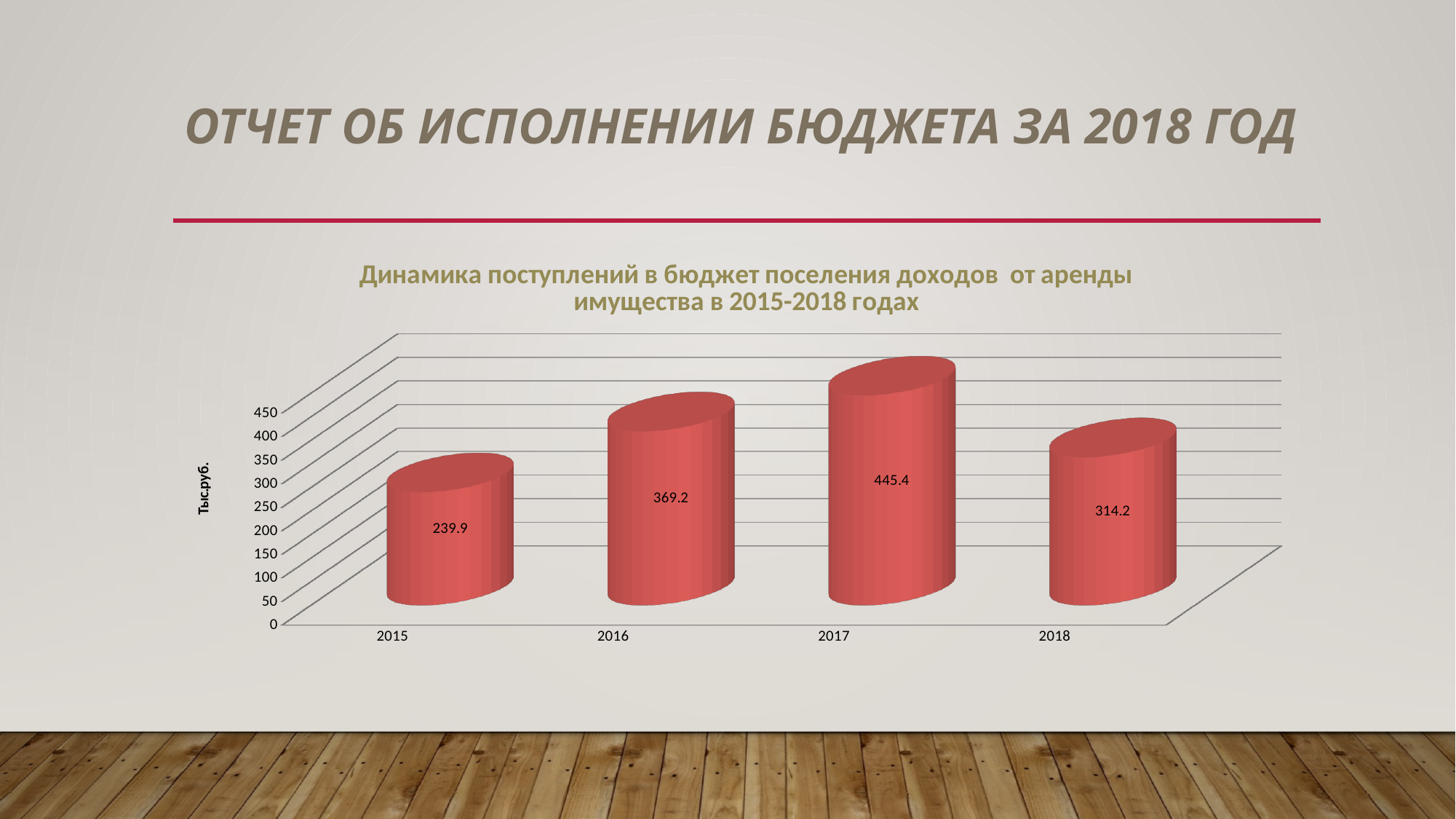
What is the difference between the values for 2017 and 2016? 76.2 Which is larger, the value for 2016 or the value for 2018? 2016 Which year has the lowest value? 2015 What unit is shown on the vertical axis label? Тыс.руб. What kind of chart is this? bar chart What is the value for 2018? 314.2 Which year has the highest value? 2017 Does the value rise or fall from 2017 to 2018? fall How many years are shown on the x axis? 4 What is the value for 2015? 239.9 What is the value for 2017? 445.4 What is the difference between the values for 2018 and 2015? 74.3